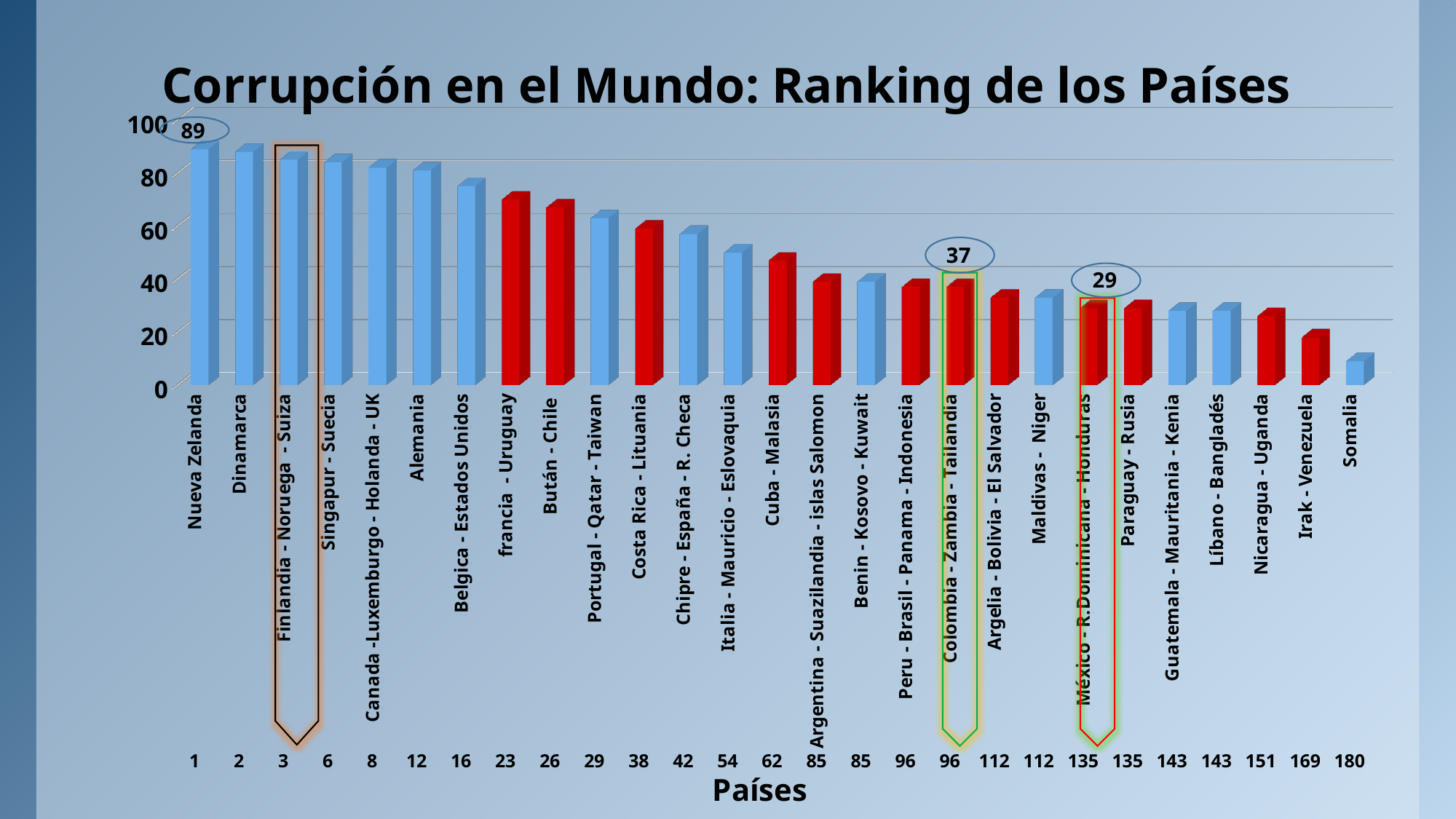
What is the value shown for Colombia - Zambia - Tailandia? 37 What type of chart is shown on the slide? bar chart Which category has the highest bar? Nueva Zelanda What is the value shown for Nueva Zelanda? 89 Which has a higher bar, Bután - Chile or Costa Rica - Lituania? Bután - Chile Do the bar values rise or fall from left to right along the x axis? fall Is the value for Somalia greater or less than 20? less What is the difference between the values for Colombia - Zambia - Tailandia and México - R.Dominicana - Honduras? 8 What is the difference between the values for Nueva Zelanda and Colombia - Zambia - Tailandia? 52 What is the value shown for México - R.Dominicana - Honduras? 29 What is the title of the chart? Corrupción en el Mundo: Ranking de los Países Which category has the lowest bar? Somalia